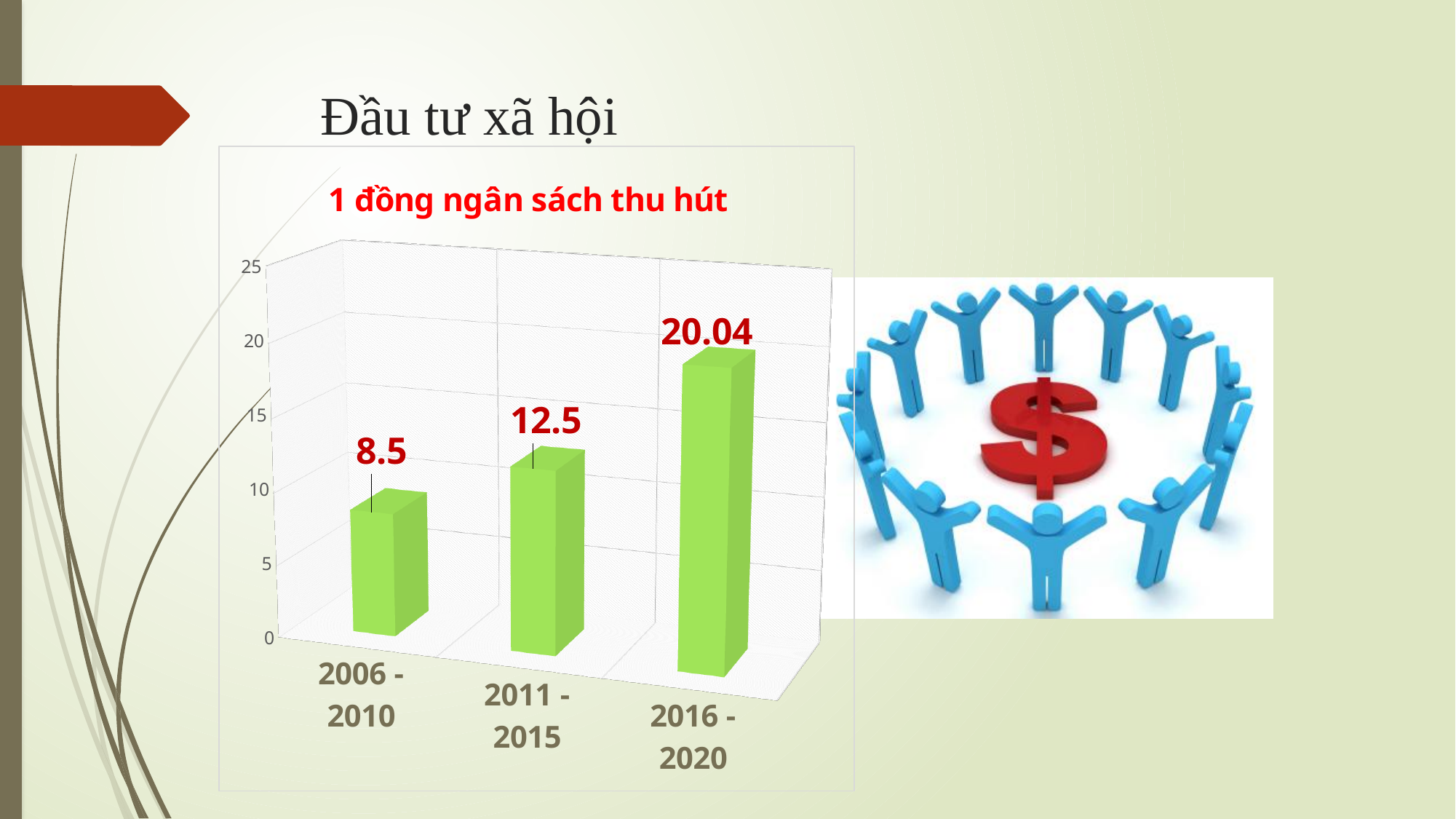
Which period has the lowest value? 2006 - 2010 What is the difference between the values for 2011 - 2015 and 2006 - 2010? 4 Do the values rise or fall from 2006 - 2010 to 2016 - 2020? rise What is the value for 2006 - 2010? 8.5 What is the difference between the values for 2016 - 2020 and 2011 - 2015? 7.54 How many periods are shown on the chart? 3 What is the value for 2011 - 2015? 12.5 What is the value for 2016 - 2020? 20.04 Which is larger, the value for 2006 - 2010 or the value for 2011 - 2015? 2011 - 2015 What kind of chart is shown on the slide? bar chart Which period has the highest value? 2016 - 2020 Is the value for 2016 - 2020 greater or less than 15? greater